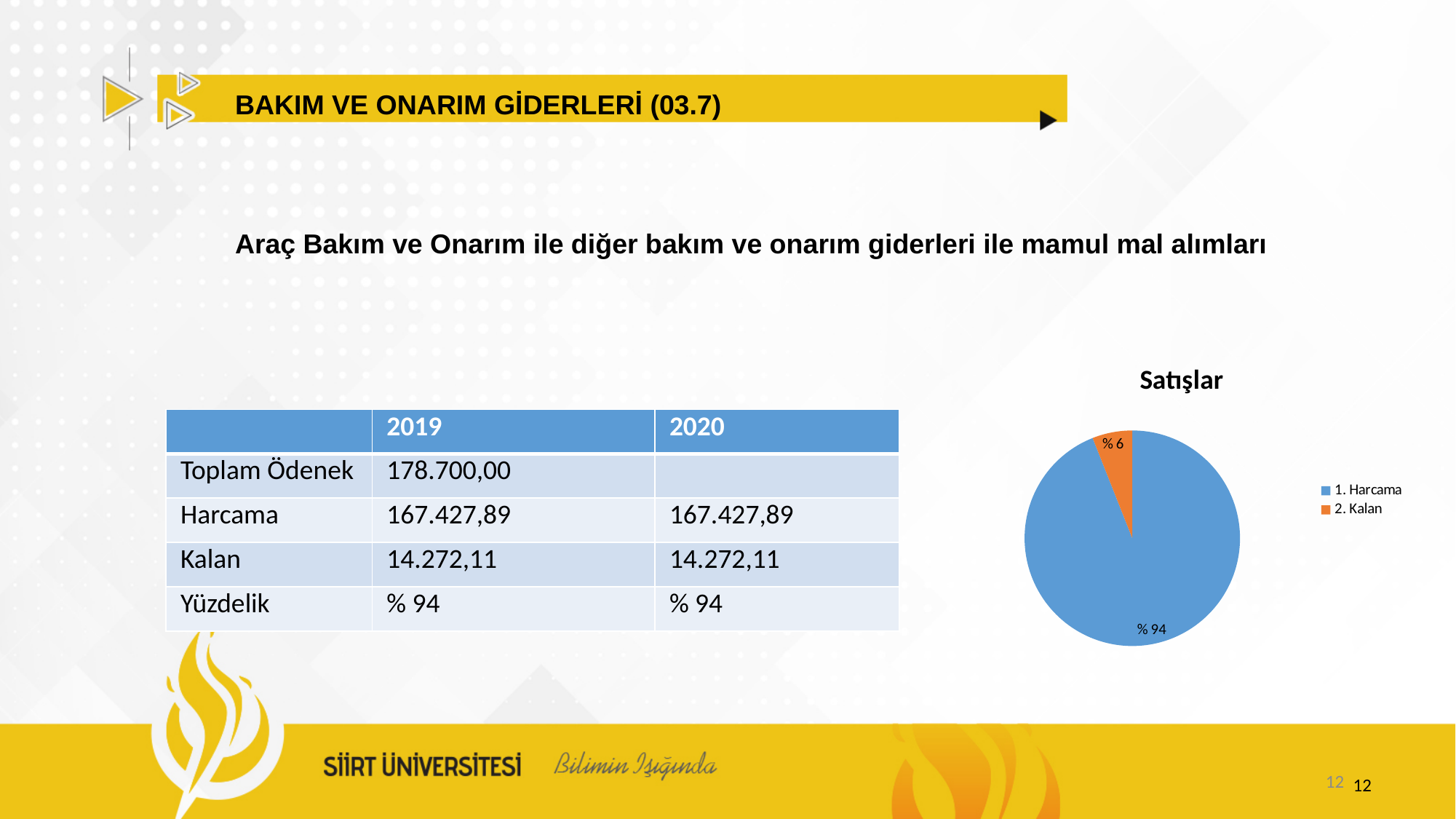
Which is larger in the pie chart, 1. Harcama or 2. Kalan? 1. Harcama What is the title of the pie chart? Satışlar What share of the pie does 1. Harcama have? % 94 How many slices does the pie chart have? 2 How many entries does the legend of the pie chart list? 2 What kind of chart is shown on the slide? pie chart What share of the pie does 2. Kalan have? % 6 Which slice of the pie chart is the largest? 1. Harcama Which slice of the pie chart is the smallest? 2. Kalan What colour is the 2. Kalan slice in the pie chart? orange What is the difference in percentage points between the 1. Harcama and 2. Kalan slices? 88